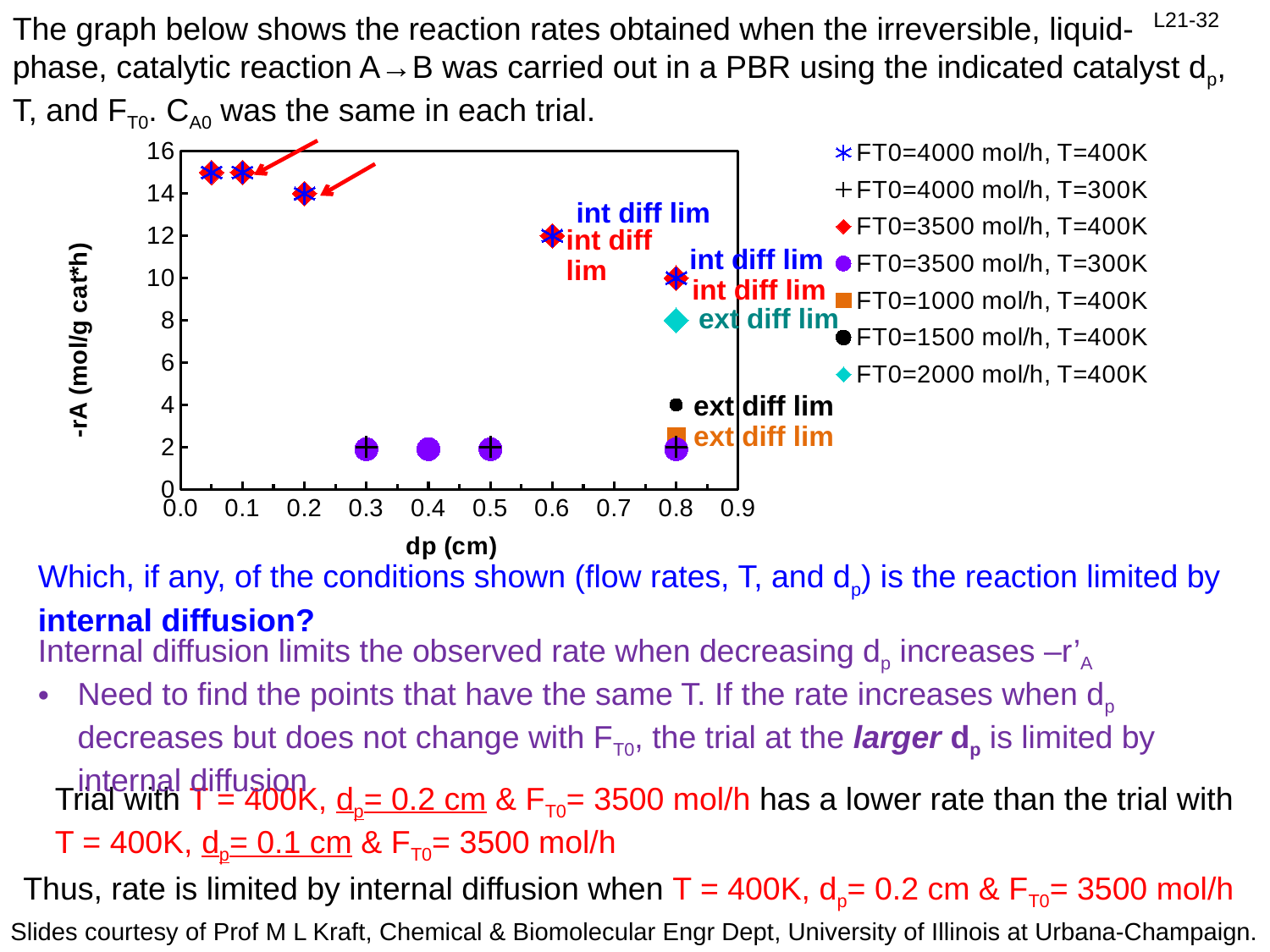
How many series does the chart legend list? 7 Are the values for the T=300K series at dp = 0.3, 0.4 and 0.5 cm greater or less than 4? less What kind of chart is shown on the slide? scatter chart Is the value for the FT0=1500 mol/h, T=400K series at dp = 0.8 cm greater or less than 6? less Is the value for the FT0=4000 mol/h, T=400K series at dp = 0.2 cm greater or less than 10? greater For the T=400K trials, do the reaction rates rise or fall as dp increases along the x axis? fall Among the T=400K points at dp = 0.8 cm, which series has the lowest reaction rate? FT0=1000 mol/h, T=400K What is the title of the y axis of the chart? -rA (mol/g cat*h) At dp = 0.8 cm, which is larger: the value for FT0=3500 mol/h, T=400K or the value for FT0=2000 mol/h, T=400K? FT0=3500 mol/h, T=400K What is the title of the x axis of the chart? dp (cm) What is the reaction rate -rA at dp = 0.8 cm for the FT0=2000 mol/h, T=400K series? 8 What is the reaction rate -rA at dp = 0.6 cm for the FT0=3500 mol/h, T=400K series? 12